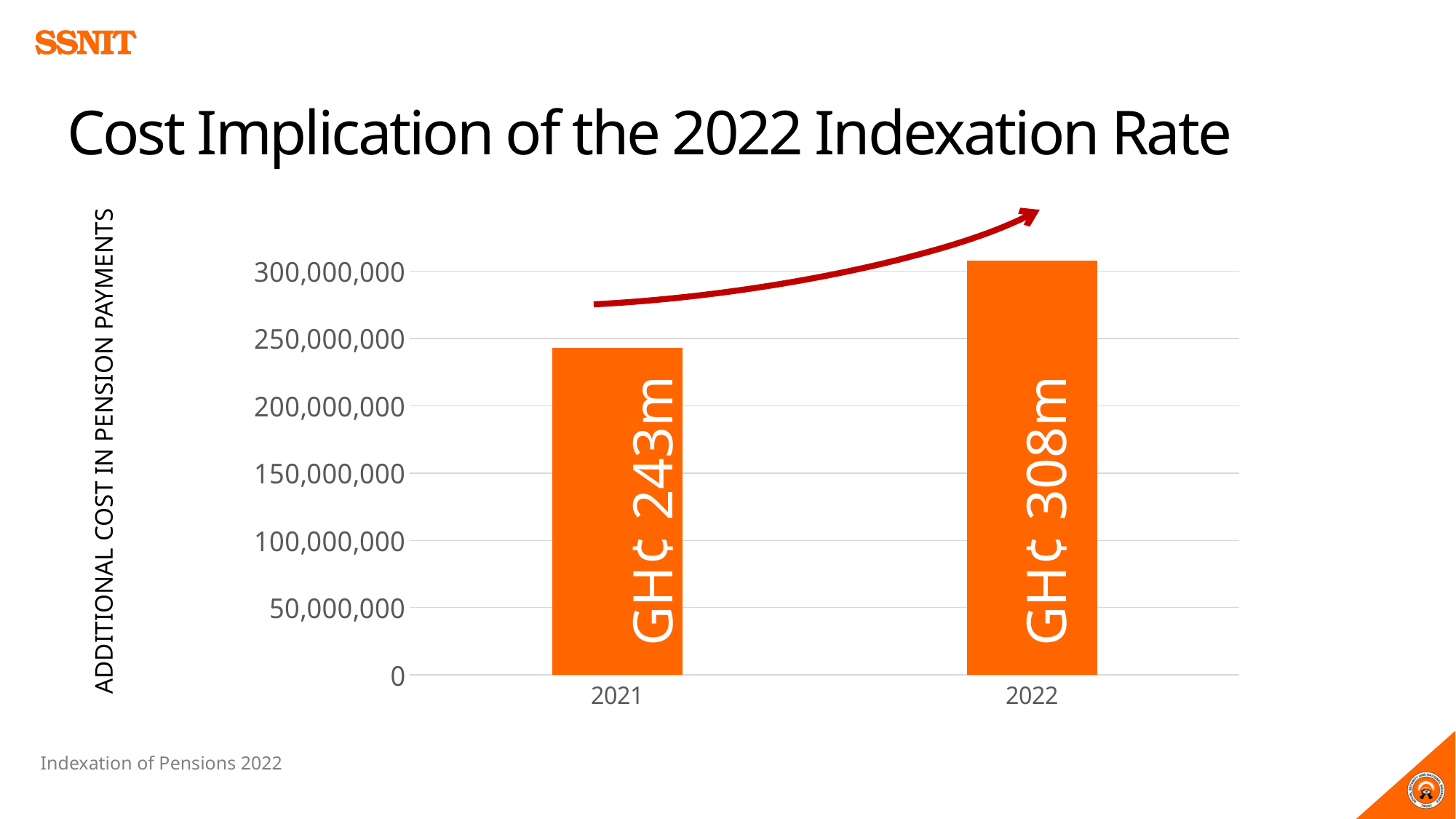
What is the additional cost in pension payments for 2021? GH₵ 243m What is the additional cost in pension payments for 2022? GH₵ 308m What colour are the bars in the chart? Orange Is the additional cost for 2022 greater or less than 300,000,000? greater What is the label on the vertical axis of the chart? ADDITIONAL COST IN PENSION PAYMENTS By how much does the additional cost in 2022 exceed that of 2021? GH₵ 65m What kind of chart is shown on the slide? Bar chart Does the additional cost in pension payments rise or fall from 2021 to 2022? Rise Which year has the higher additional cost in pension payments? 2022 How many years are shown on the chart? 2 Is the additional cost for 2021 greater or less than 250,000,000? less Which year has the lower additional cost in pension payments? 2021